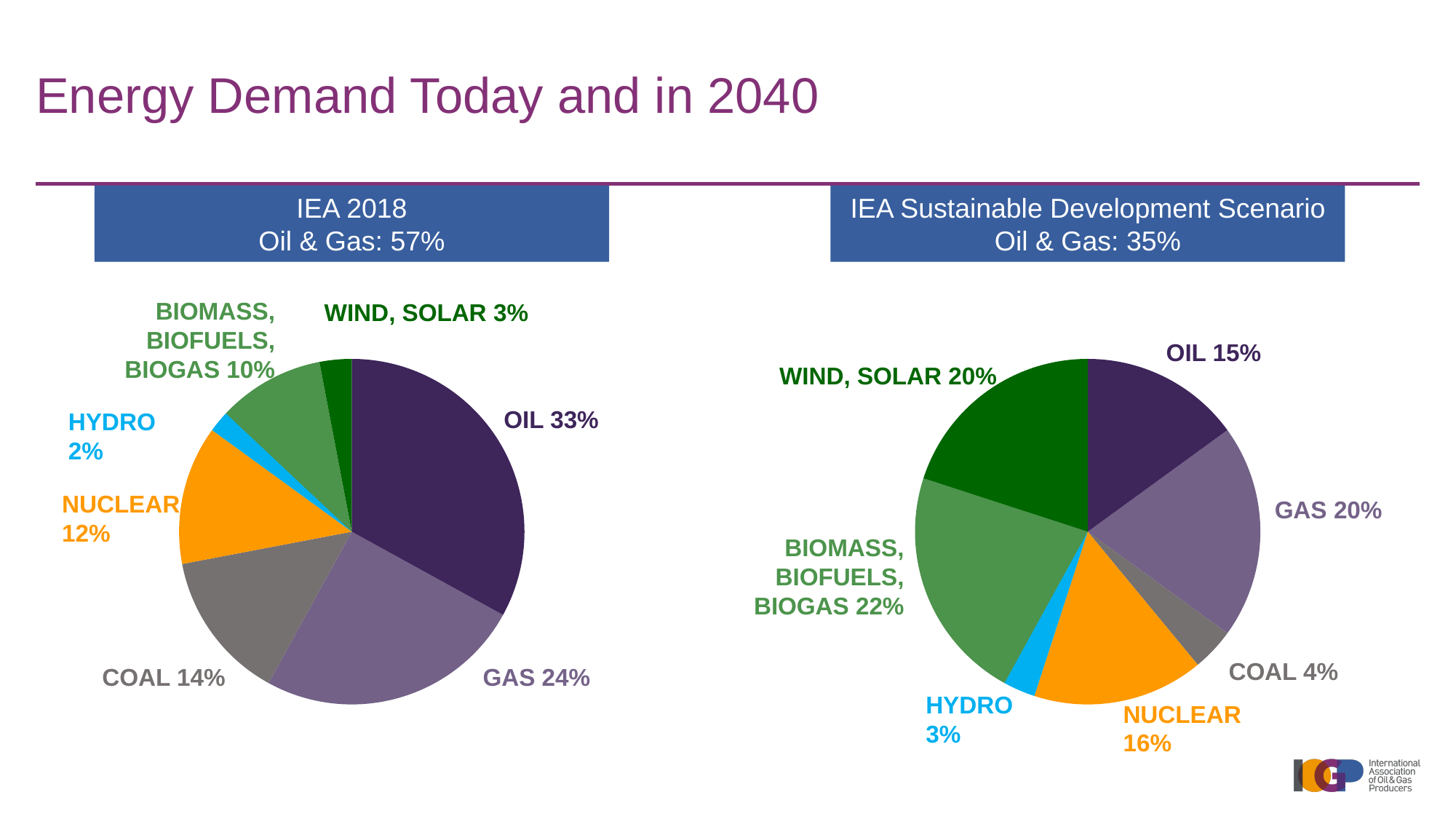
In the IEA 2018 pie chart, what is the combined share of Coal and Nuclear? 26% What type of chart is used on the left side of the slide for IEA 2018? Pie chart In the IEA Sustainable Development Scenario pie chart, which category has the smallest share? Hydro What is the Oil & Gas share stated in the header above the IEA Sustainable Development Scenario chart? 35% In the IEA 2018 pie chart, what share does Oil have? 33% What is the difference between the Oil share in the IEA 2018 chart and the Oil share in the IEA Sustainable Development Scenario chart? 18% How many categories are shown in the IEA 2018 pie chart? 7 In the IEA Sustainable Development Scenario pie chart, which is larger: Nuclear or Oil? Nuclear In the IEA 2018 pie chart, which category has the smallest share? Hydro In the IEA 2018 pie chart, which category has the largest share? Oil In the IEA Sustainable Development Scenario pie chart, what share does Wind, Solar have? 20% In the IEA Sustainable Development Scenario pie chart, which category has the largest share? Biomass, Biofuels, Biogas